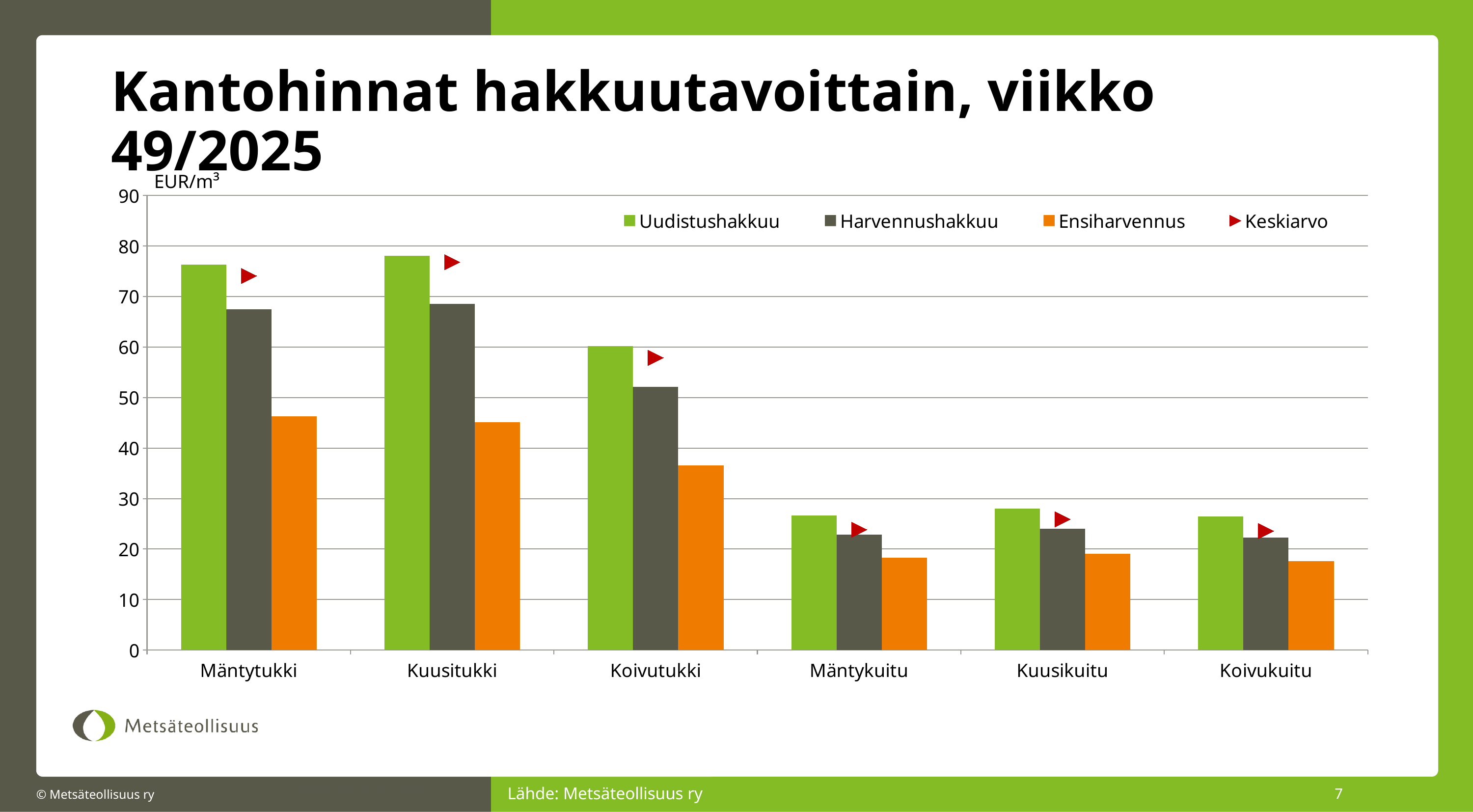
How many categories are shown on the x axis? 6 Is the Uudistushakkuu value for Koivutukki greater or less than 50? greater Is the Ensiharvennus value for Mäntytukki greater or less than 50? less How many series does the legend list? 4 Is the Harvennushakkuu value for Kuusitukki greater or less than 60? greater Which series is shown in orange? Ensiharvennus What unit is shown on the y axis? EUR/m³ What kind of chart is shown on the slide? bar chart For Mäntytukki, which is larger: the Uudistushakkuu value or the Harvennushakkuu value? Uudistushakkuu Which is larger: the Ensiharvennus value for Koivutukki or the Ensiharvennus value for Mäntykuitu? Koivutukki